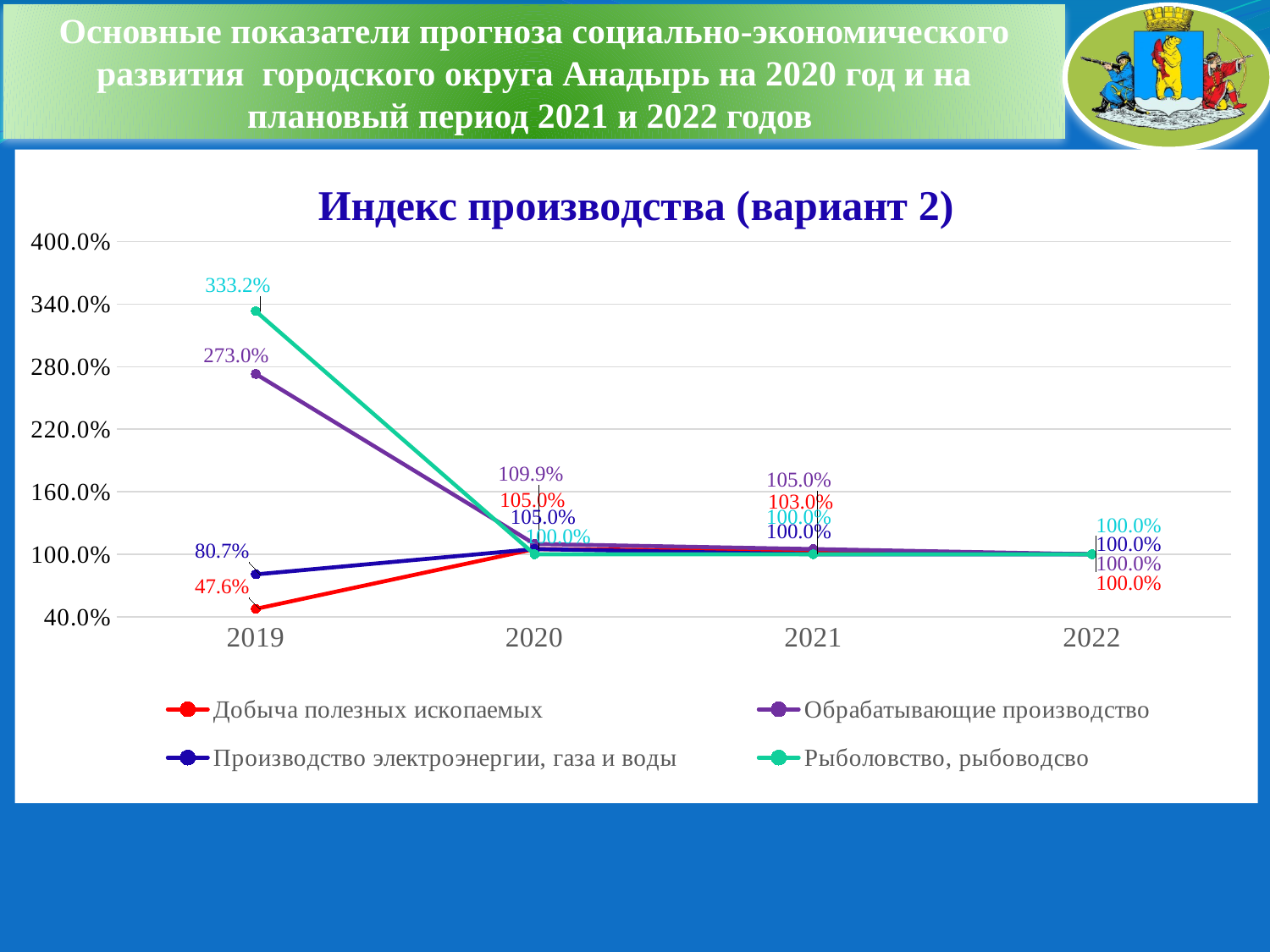
Which series has the highest value in 2019? Рыболовство, рыбоводсво What is the title of the chart? Индекс производства (вариант 2) What is the value for Добыча полезных ископаемых in 2019? 47.6% What is the difference between the 2019 values of Рыболовство, рыбоводсво and Обрабатывающие производство? 60.2% Does the value for Рыболовство, рыбоводсво rise or fall from 2019 to 2020? fall What kind of chart is shown on the slide? line chart Which series has the lowest value in 2019? Добыча полезных ископаемых How many years are shown on the x axis? 4 What is the value for Рыболовство, рыбоводсво in 2019? 333.2% What is the value for Производство электроэнергии, газа и воды in 2019? 80.7% How many series does the legend list? 4 What is the value for Обрабатывающие производство in 2019? 273.0%